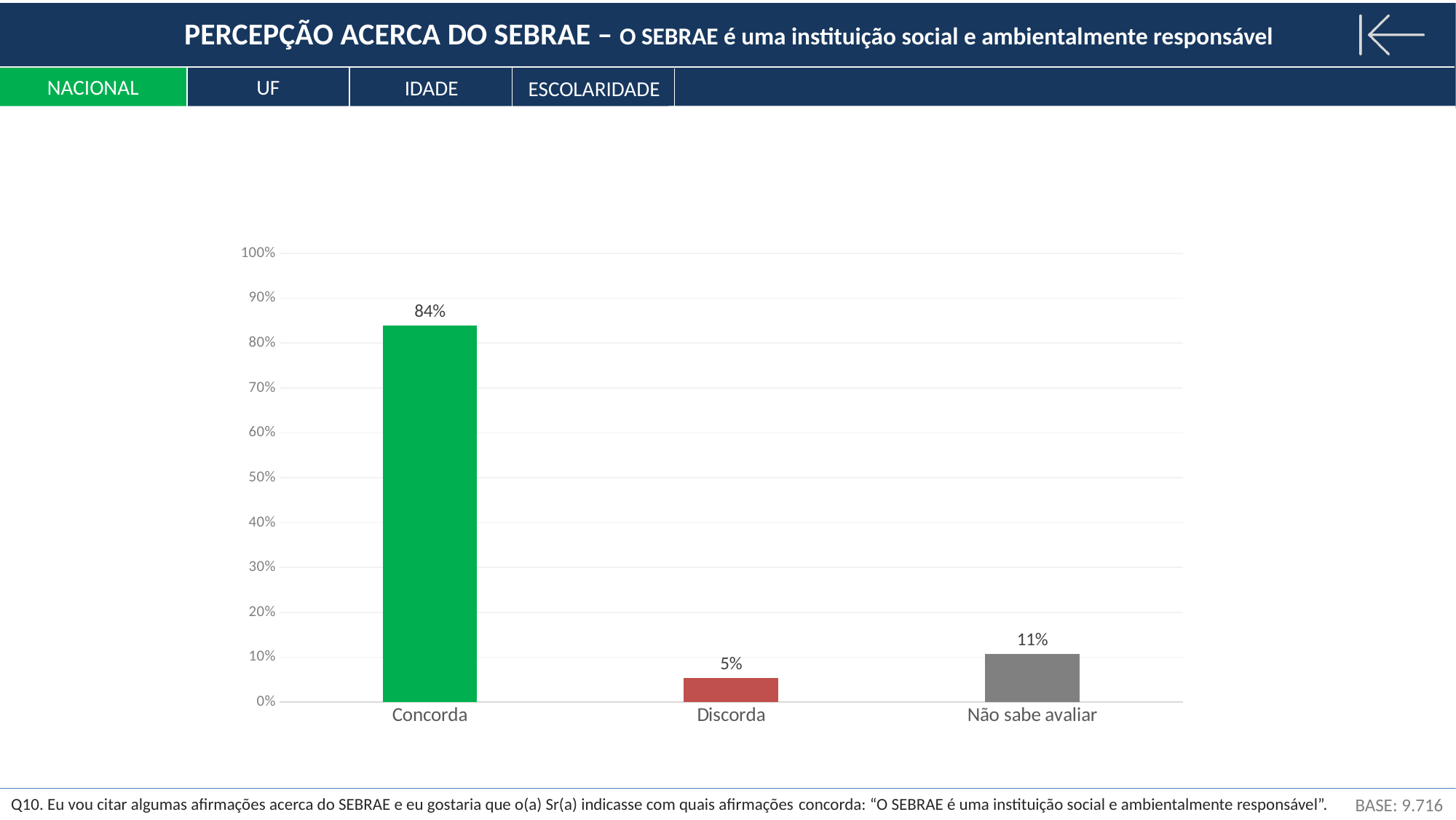
What is the difference between the values for Concorda and Não sabe avaliar? 73% What kind of chart is shown on the slide? bar chart What is the value for Não sabe avaliar? 11% What is the difference between the values for Não sabe avaliar and Discorda? 6% What is the value for Discorda? 5% Which category has the highest value? Concorda Which is larger, the value for Discorda or the value for Não sabe avaliar? Não sabe avaliar What is the value for Concorda? 84% What colour is the bar for Concorda? green Is the value for Concorda greater or less than 80%? greater Which category has the lowest value? Discorda How many categories are shown on the x axis? 3